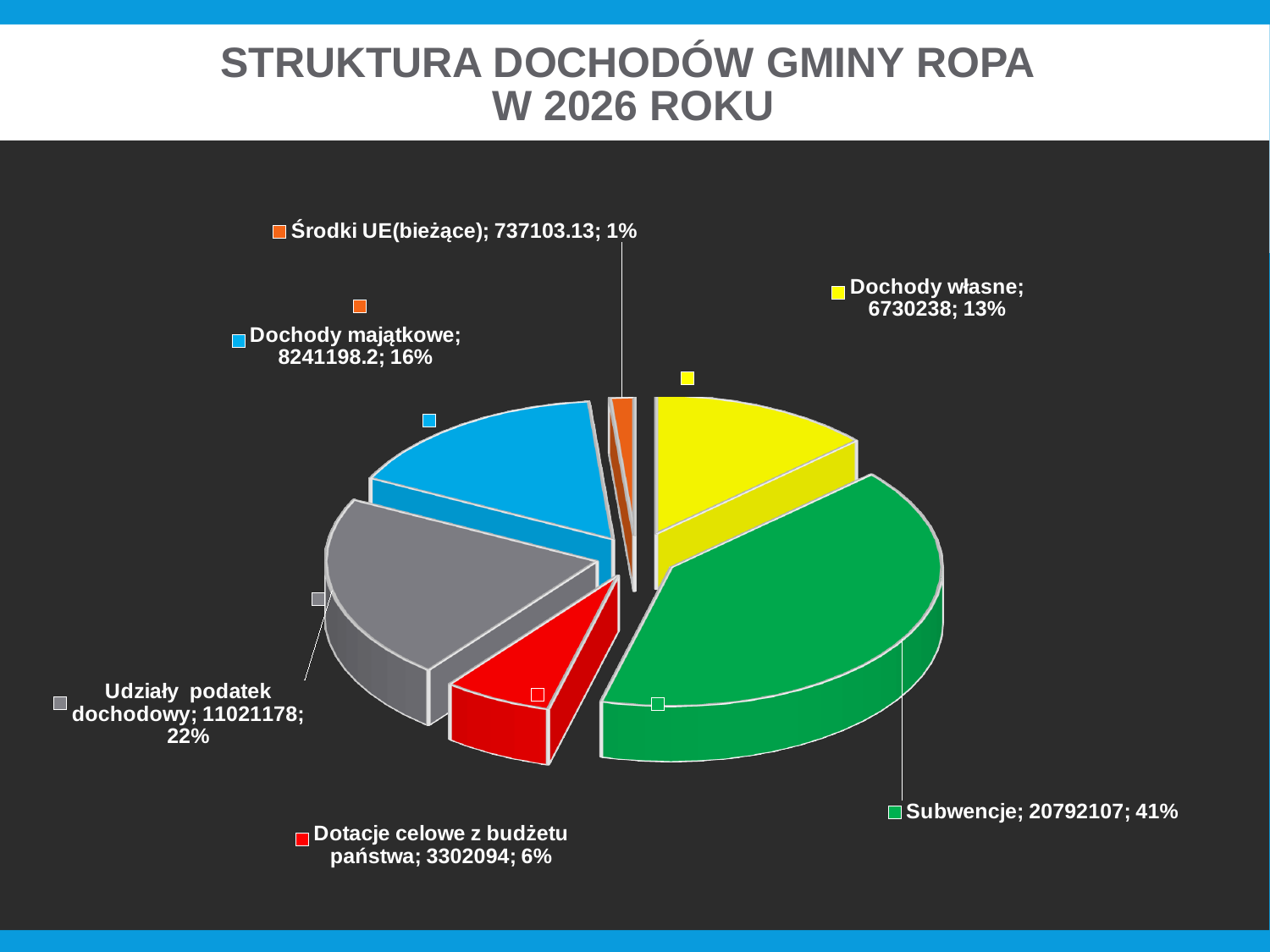
How many categories are shown in the pie chart? 6 What is the difference between the values for Subwencje and Udziały podatek dochodowy? 9770929 What is the value shown for Środki UE(bieżące)? 737103.13 Which category has the smallest share of the pie? Środki UE(bieżące) What is the value shown for Subwencje? 20792107 What percentage share does Dochody majątkowe have? 16% What is the value shown for Dotacje celowe z budżetu państwa? 3302094 What kind of chart is shown on the slide? Pie chart What percentage share does Udziały podatek dochodowy have? 22% What is the title of the slide? STRUKTURA DOCHODÓW GMINY ROPA W 2026 ROKU Which is larger, Dochody własne or Dochody majątkowe? Dochody majątkowe Which category has the largest share of the pie? Subwencje